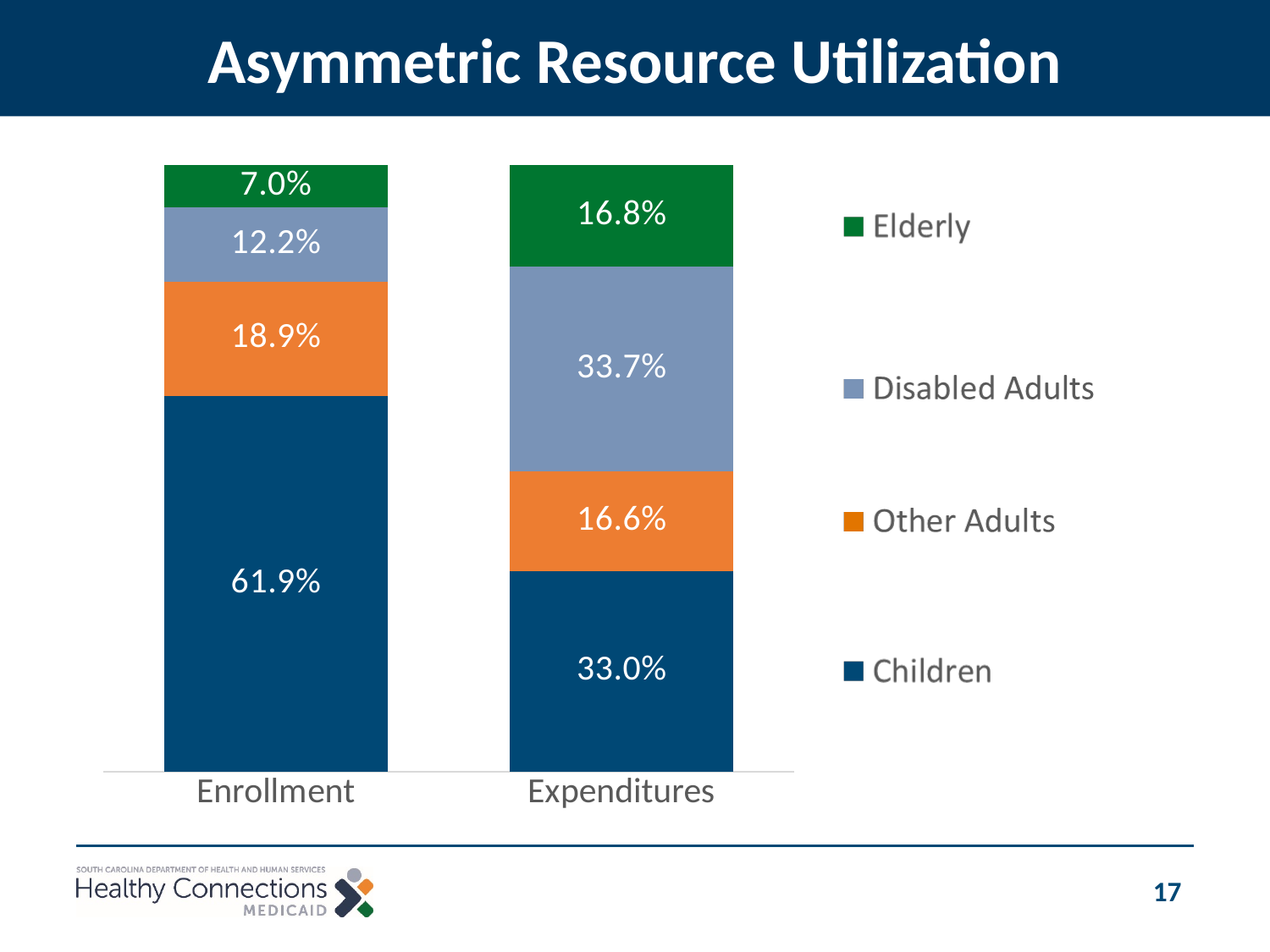
What is the Other Adults value for Expenditures? 16.6% What is the title of the slide containing the chart? Asymmetric Resource Utilization What kind of chart is shown on the slide? Stacked bar chart What is the Elderly value for Enrollment? 7.0% How many series does the legend list? 4 Is the Elderly share larger for Enrollment or for Expenditures? Expenditures What is the difference between the Disabled Adults share of Expenditures and the Disabled Adults share of Enrollment? 21.5% What is the difference between the Children share of Enrollment and the Children share of Expenditures? 28.9% What share of Enrollment is Children? 61.9% What share of Expenditures is Disabled Adults? 33.7% Which group has the smallest share of Enrollment? Elderly Which group has the largest share of Enrollment? Children